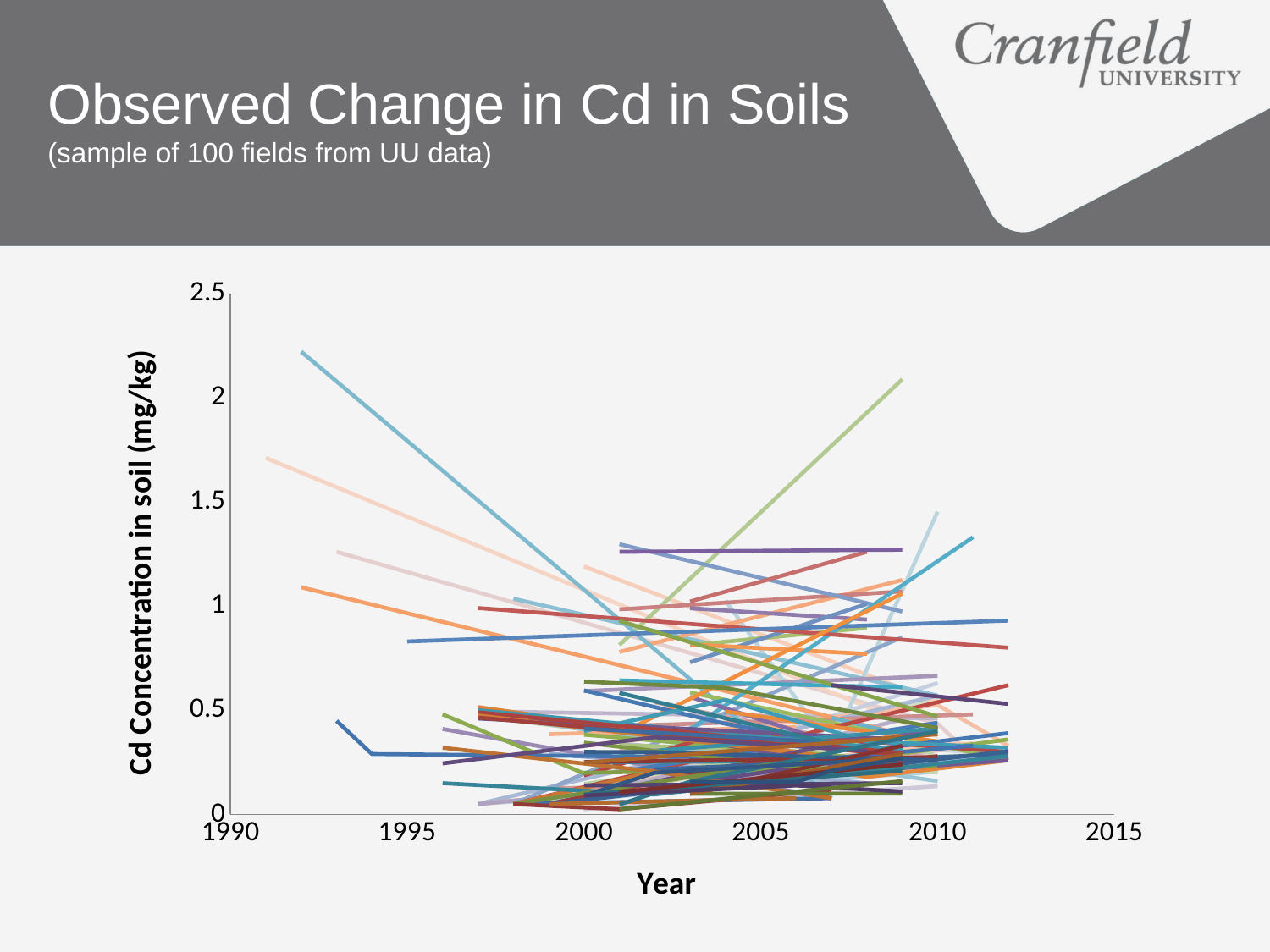
What kind of chart is shown on the slide? line chart Is the latest year reached by any line on the chart greater or less than 2015? less What is the label of the vertical axis of the chart? Cd Concentration in soil (mg/kg) Is the earliest year at which any line starts greater or less than 1995? less According to the subtitle, how many fields are plotted on the chart? 100 Is the highest Cd concentration plotted on the chart greater or less than 2 mg/kg? greater What is the label of the horizontal axis of the chart? Year